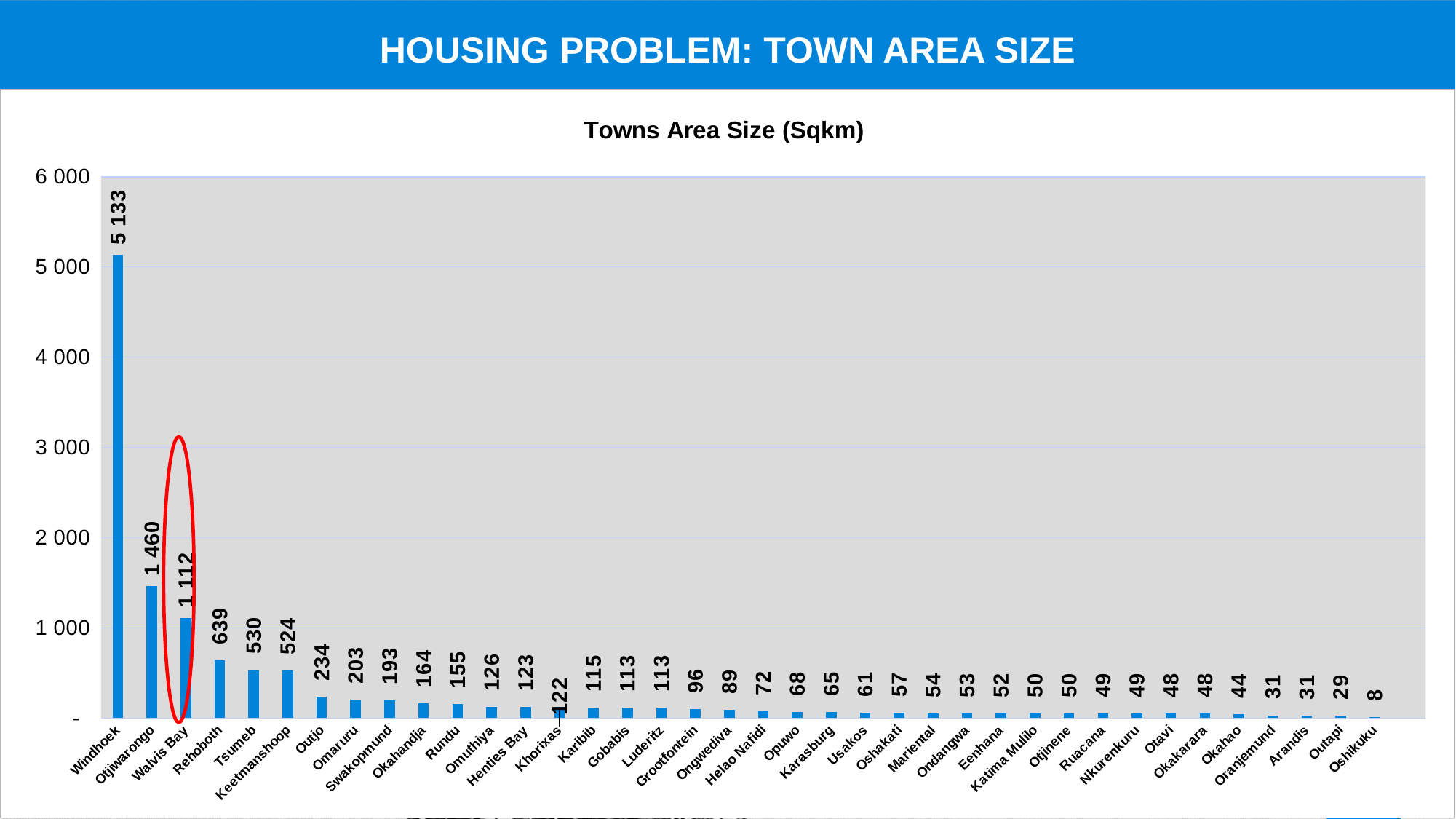
What type of chart is shown? Bar chart Which town has the smallest area size? Oshikuku Which town has the largest area size? Windhoek What is the area size shown for Keetmanshoop? 524 What is the area size shown for Oshikuku? 8 How many towns are shown on the chart? 38 What is the difference between the area sizes of Windhoek and Otjiwarongo? 3 673 What is the area size shown for Walvis Bay? 1 112 What is the difference between the area sizes of Rehoboth and Tsumeb? 109 Which has a larger area size, Swakopmund or Okahandja? Swakopmund What is the area size shown for Windhoek? 5 133 Which town's bar is circled in red on the chart? Walvis Bay